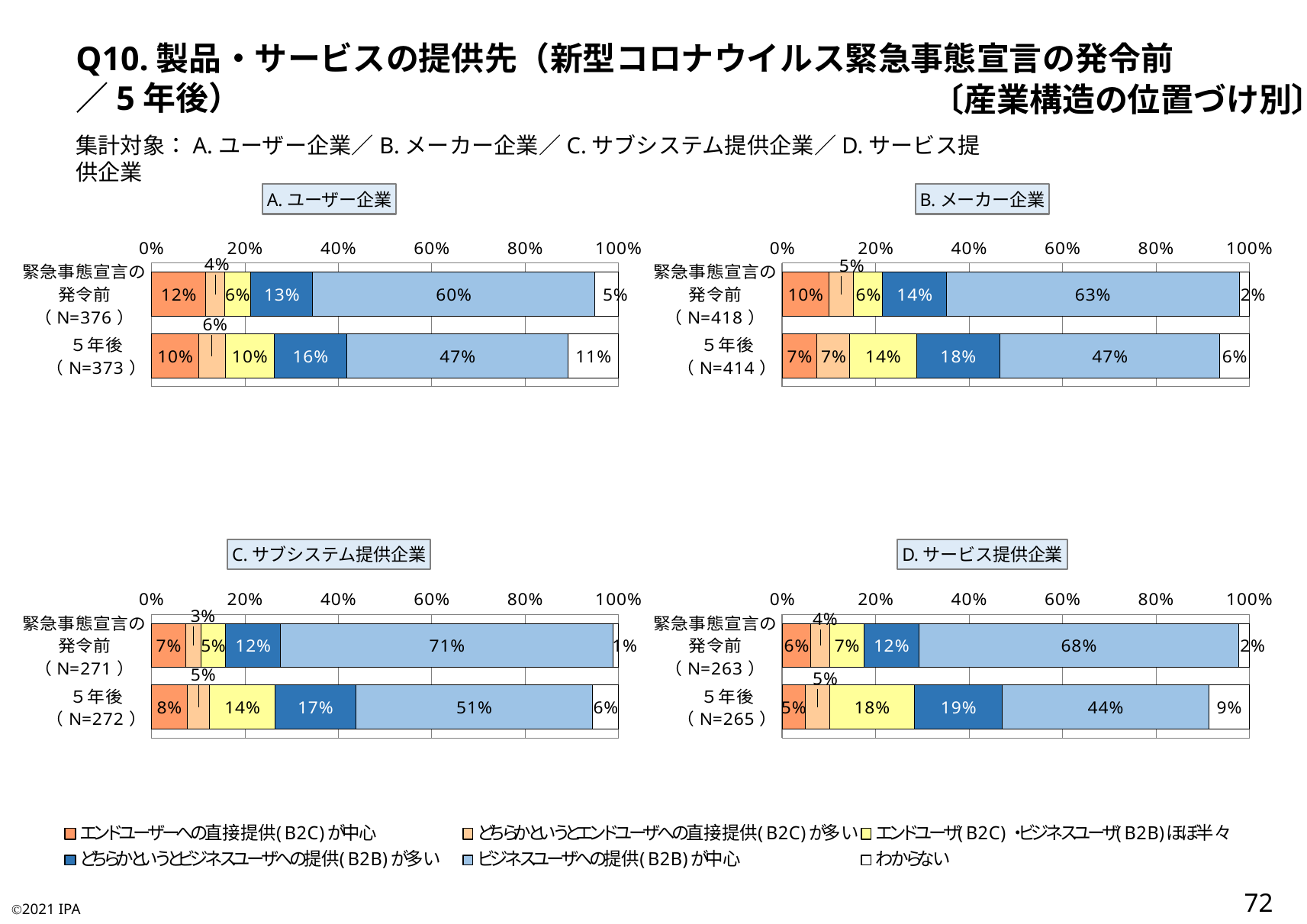
In the chart titled C. サブシステム提供企業, what is the value of ビジネスユーザへの提供(B2B)が中心 for 緊急事態宣言の発令前? 71% In the chart titled B. メーカー企業, what is the value of どちらかというとビジネスユーザへの提供(B2B)が多い for 5年後? 18% In the chart titled B. メーカー企業, which is larger for 5年後: エンドユーザ(B2C)・ビジネスユーザ(B2B)ほぼ半々 or どちらかというとビジネスユーザへの提供(B2B)が多い? どちらかというとビジネスユーザへの提供(B2B)が多い In the chart titled A. ユーザー企業, which segment is the smallest for 緊急事態宣言の発令前? どちらかというとエンドユーザへの直接提供(B2C)が多い In the chart titled C. サブシステム提供企業, how many categories (bars) are shown? 2 How many series does the legend list? 6 What kind of chart is the chart titled B. メーカー企業? Stacked bar chart In the chart titled A. ユーザー企業, what is the value of ビジネスユーザへの提供(B2B)が中心 for 緊急事態宣言の発令前? 60% In the chart titled C. サブシステム提供企業, which segment is the largest for 5年後? ビジネスユーザへの提供(B2B)が中心 In the chart titled D. サービス提供企業, what is the value of エンドユーザ(B2C)・ビジネスユーザ(B2B)ほぼ半々 for 5年後? 18% In the chart titled A. ユーザー企業, what is the value of わからない for 5年後? 11% In the chart titled D. サービス提供企業, what is the difference between the ビジネスユーザへの提供(B2B)が中心 values for 緊急事態宣言の発令前 and 5年後? 24%